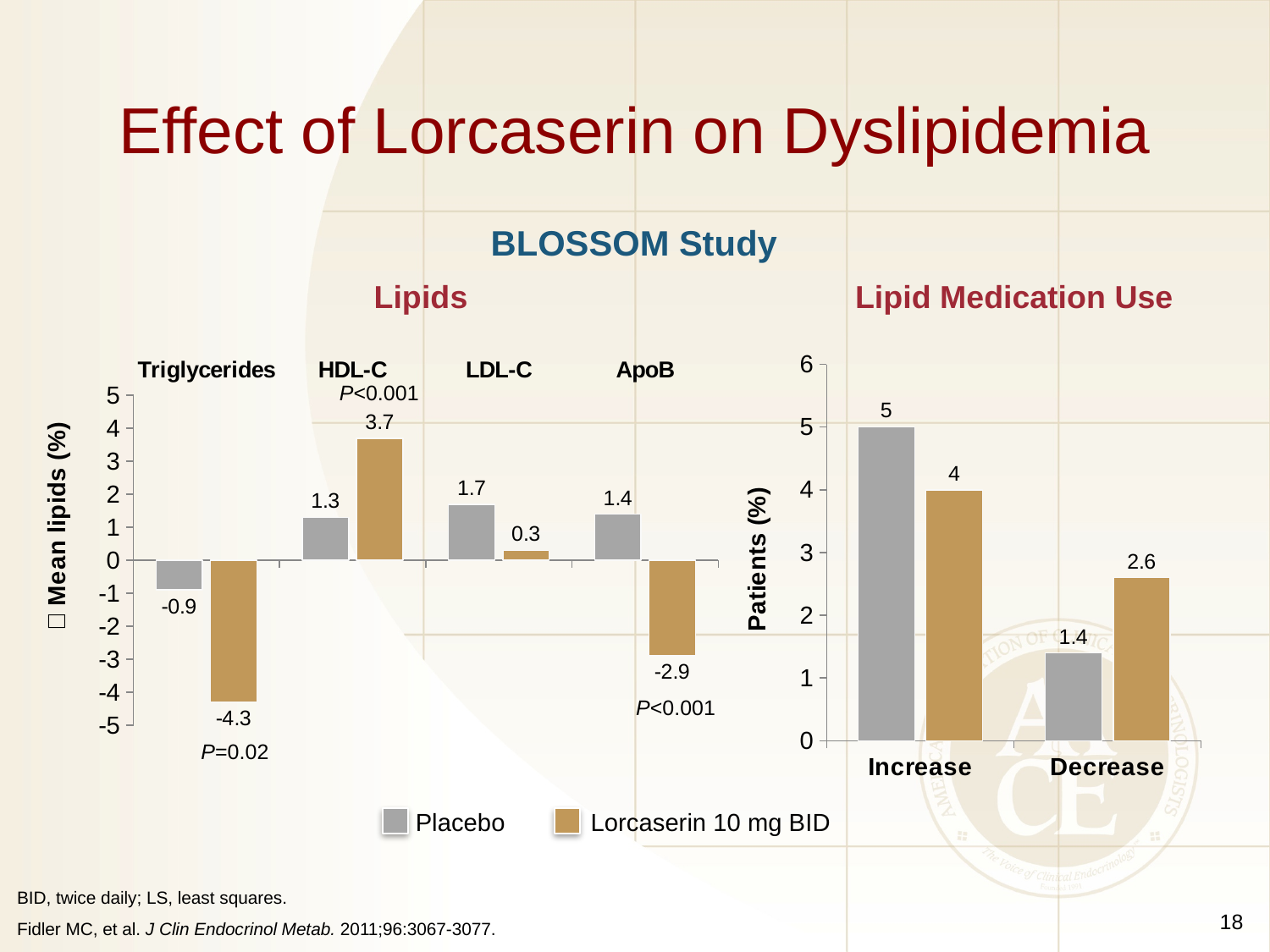
In the Lipid Medication Use chart, what is the Lorcaserin 10 mg BID value for Decrease? 2.6 In the Lipid Medication Use chart, what is the difference between the Lorcaserin 10 mg BID and Placebo values for Decrease? 1.2 In the Lipids chart, which is larger for ApoB: the Placebo value or the Lorcaserin 10 mg BID value? Placebo In the Lipids chart, which lipid category has the lowest Lorcaserin 10 mg BID value? Triglycerides In the Lipids chart, what is the value for Placebo for HDL-C? 1.3 In the Lipids chart, what is the value for Lorcaserin 10 mg BID for Triglycerides? -4.3 In the Lipids chart, what is the value for Lorcaserin 10 mg BID for LDL-C? 0.3 In the Lipids chart, what is the difference between the Lorcaserin 10 mg BID and Placebo values for HDL-C? 2.4 In the Lipids chart, which lipid category has the highest Lorcaserin 10 mg BID value? HDL-C How many series does the legend list? 2 What kind of chart is the Lipid Medication Use chart? Bar chart In the Lipid Medication Use chart, what is the Placebo value for Increase? 5